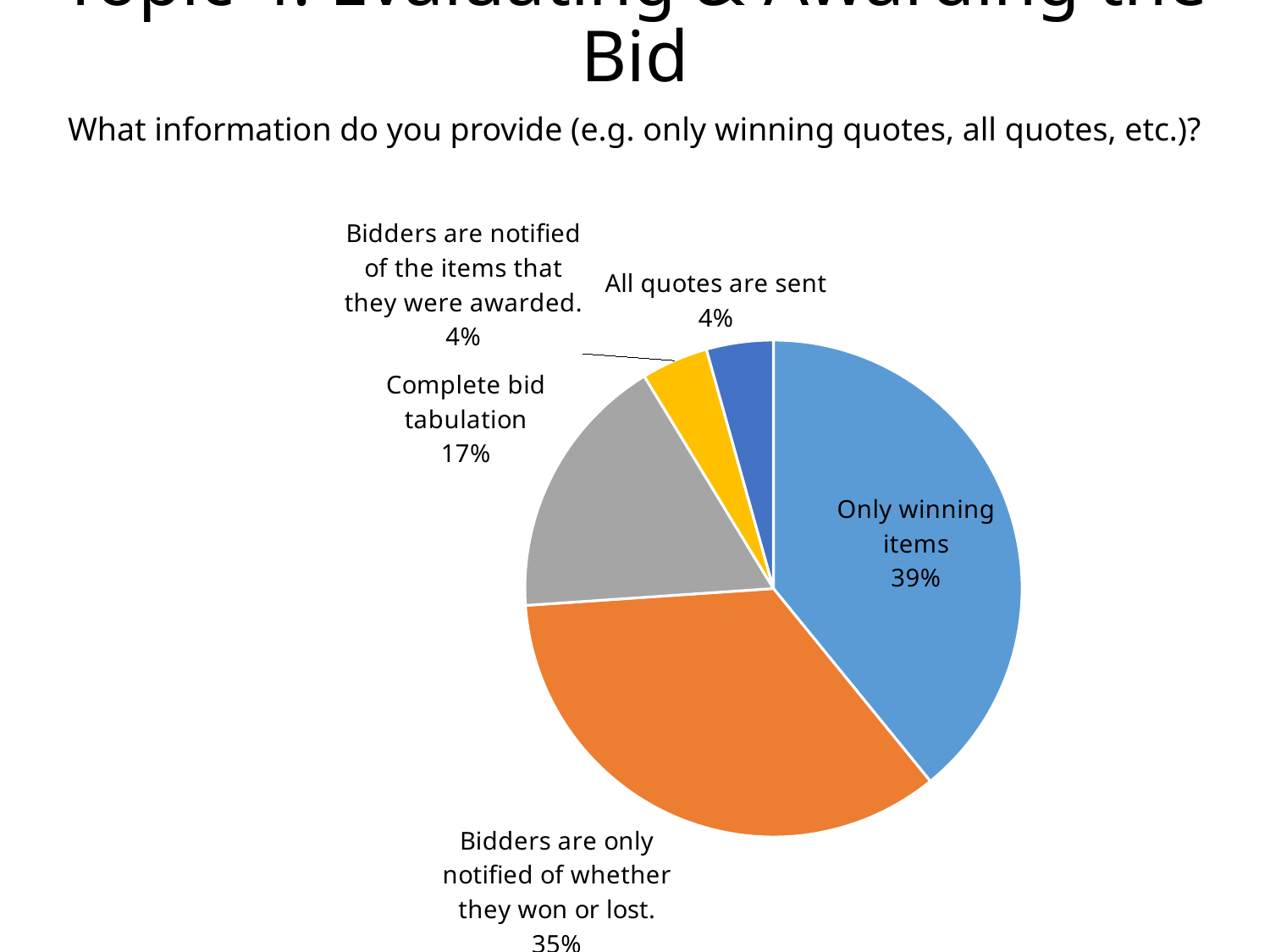
What is the difference in percentage points between "Only winning items" and "Bidders are only notified of whether they won or lost."? 4 What percentage is shown for "All quotes are sent"? 4% What is the difference in percentage points between "Complete bid tabulation" and "All quotes are sent"? 13 Which is larger: the slice for "Complete bid tabulation" or the slice for "All quotes are sent"? Complete bid tabulation What percentage is shown for "Complete bid tabulation"? 17% What question does the chart answer, as written above the pie? What information do you provide (e.g. only winning quotes, all quotes, etc.)? How many slices does the pie chart have? 5 Which category has the largest slice of the pie? Only winning items What kind of chart is shown on the slide? pie chart What percentage is shown for "Bidders are only notified of whether they won or lost."? 35% What percentage is shown for "Bidders are notified of the items that they were awarded."? 4% What share of the pie is "Only winning items"? 39%